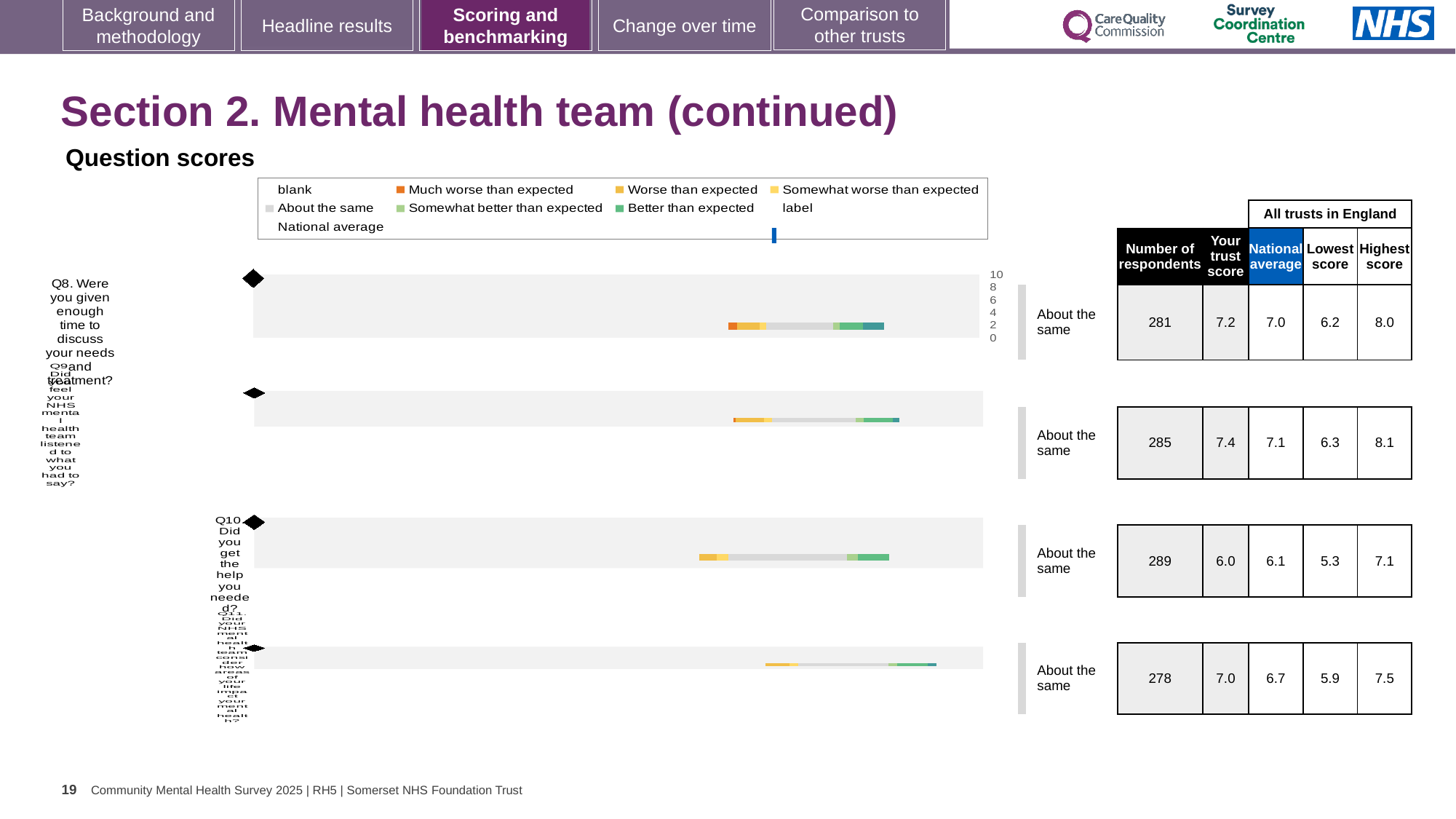
Which question has the highest 'Your trust score' on this slide? Q9 What is the national average score for Q10 (Did you get the help you needed?)? 6.1 What is the lowest score among all trusts in England for Q9? 6.3 Which question has the lowest 'Your trust score' on this slide? Q10 What is the difference between the trust score and the national average for Q8? 0.2 What is the highest score among all trusts in England for Q11? 7.5 For Q10, is the trust score higher or lower than the national average? Lower For Q11, which is larger: the trust score or the national average? The trust score How many respondents are shown for Q9 (Did you feel your NHS mental health team listened to what you had to say?)? 285 What is the 'Your trust score' for Q8 (Were you given enough time to discuss your needs and treatment?)? 7.2 What kind of chart is used to show the question scores on this slide? Bar chart How many questions are charted on this slide? 4